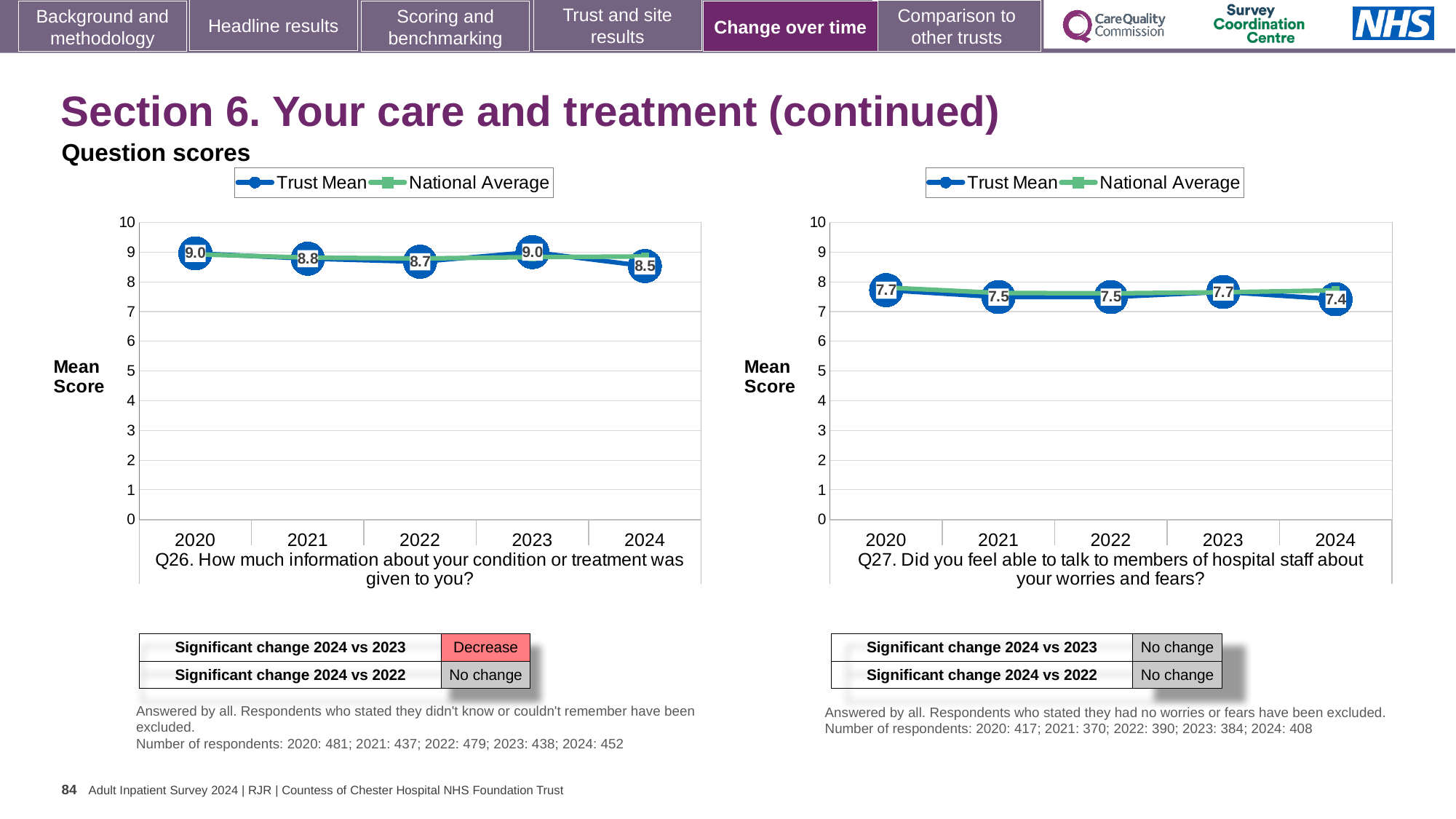
On the Q27 chart (right), which year has the lowest Trust Mean score? 2024 How many series does the legend of the Q26 chart (left) list? 2 On the Q26 chart (left), which year has the lowest Trust Mean score? 2024 On the Q27 chart (right), what is the Trust Mean score for 2024? 7.4 On the Q26 chart (left), what is the Trust Mean score for 2021? 8.8 On the Q27 chart (right), what is the difference between the Trust Mean scores for 2020 and 2021? 0.2 On the Q26 chart (left), what is the Trust Mean score for 2024? 8.5 On the Q27 chart (right), what is the Trust Mean score for 2020? 7.7 On the Q27 chart (right), is the Trust Mean score for 2024 greater or less than 8? less What kind of chart is the Q27 chart (right)? line chart On the Q26 chart (left), is the Trust Mean score for 2022 higher or lower than for 2023? lower On the Q26 chart (left), what is the difference between the Trust Mean scores for 2023 and 2024? 0.5